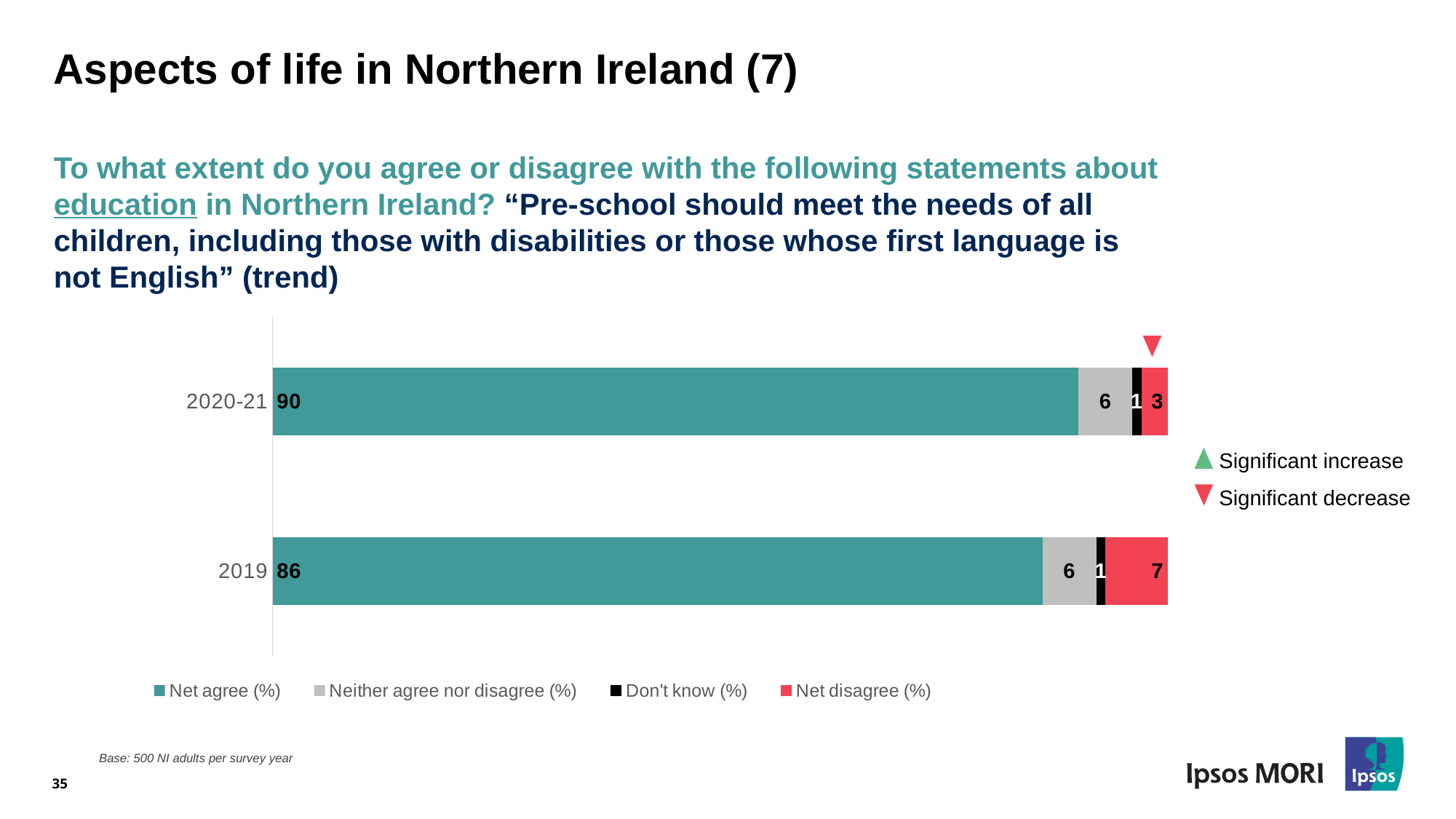
What is the Don't know (%) value for 2019? 1 What is the Net agree (%) value for 2019? 86 What is the Net disagree (%) value for 2019? 7 Which year has the higher Net agree (%) value? 2020-21 What kind of chart is shown on the slide? Stacked bar chart What is the Net disagree (%) value for 2020-21? 3 How many series does the legend list? 4 Is the Net disagree (%) value larger in 2019 or in 2020-21? 2019 What is the difference in Net agree (%) between 2020-21 and 2019? 4 What is the Net agree (%) value for 2020-21? 90 Which year has the lower Net disagree (%) value? 2020-21 What is the Neither agree nor disagree (%) value for 2020-21? 6